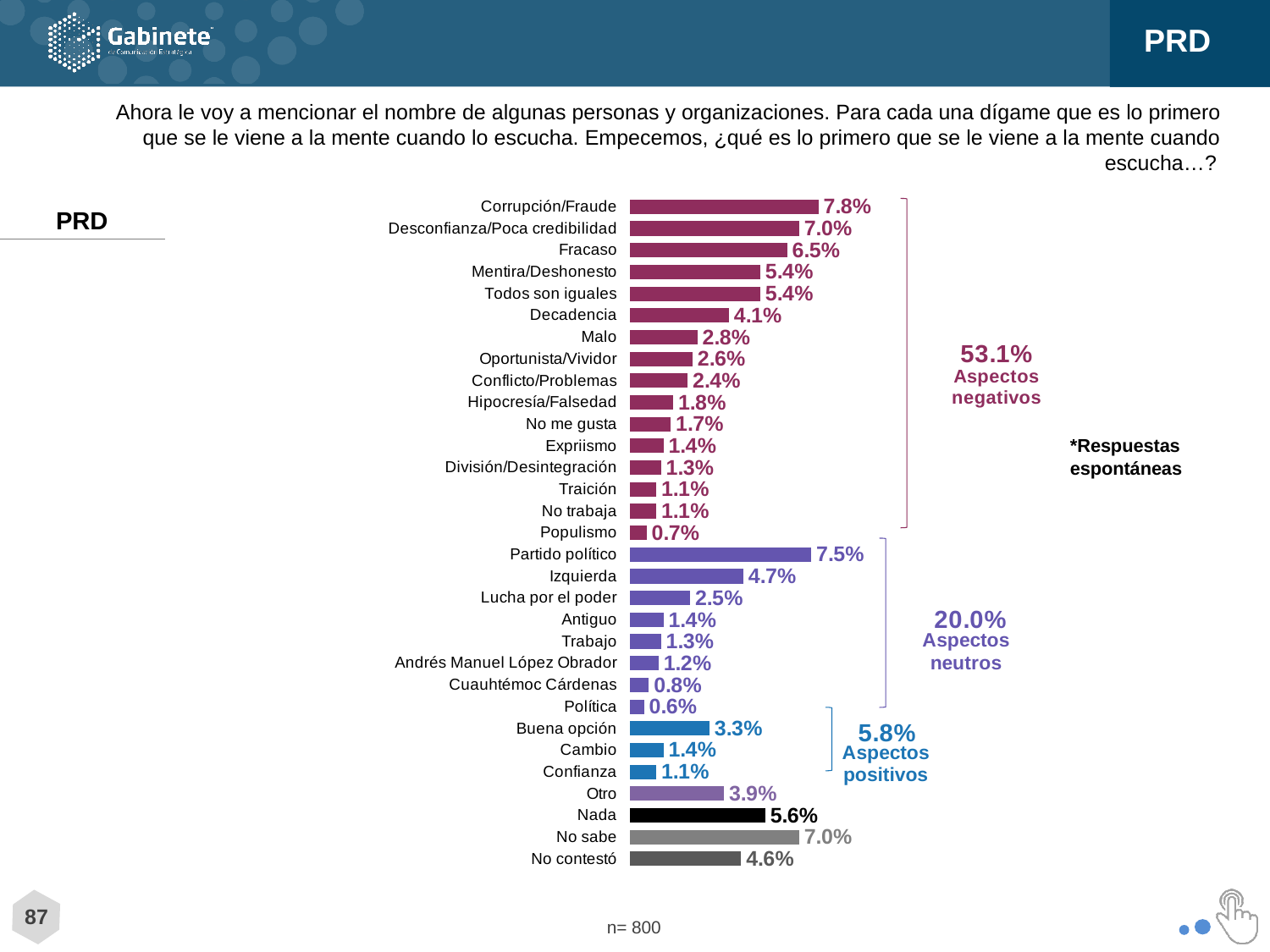
What percentage is shown for Buena opción? 3.3% What percentage is shown for Corrupción/Fraude? 7.8% Which is larger, the value for Izquierda or the value for Otro? Izquierda What total percentage is given for Aspectos positivos? 5.8% What kind of chart is shown on the slide? Bar chart What total percentage is given for Aspectos negativos? 53.1% What is the difference between the values for Corrupción/Fraude and Fracaso? 1.3% Which category has the lowest value in the chart? Política What percentage is shown for No sabe? 7.0% How many categories are plotted in the chart? 31 What percentage is shown for Partido político? 7.5% Which category has the highest value in the chart? Corrupción/Fraude